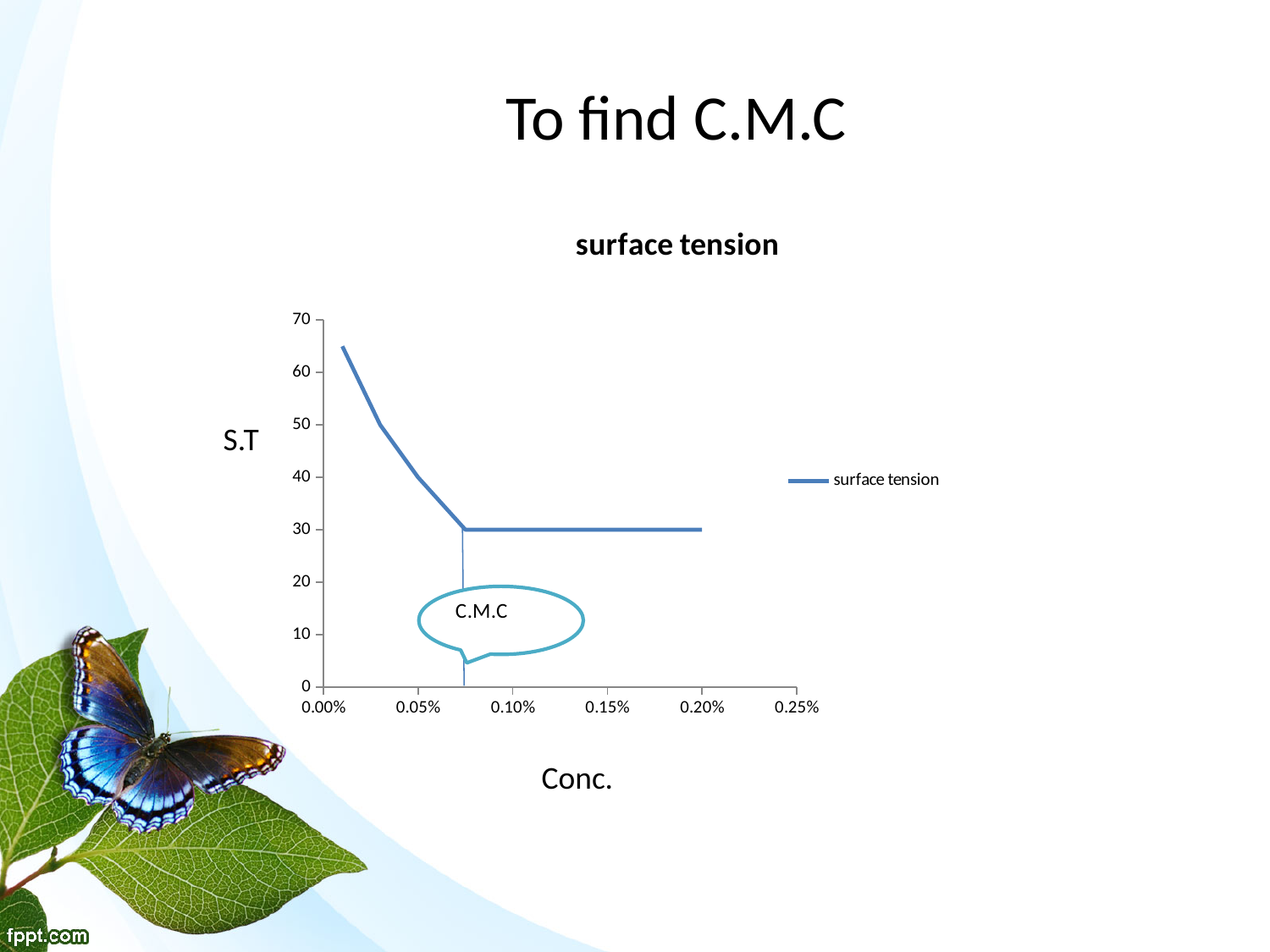
What kind of chart is shown on the slide? line chart Does the surface tension rise, fall or stay flat between 0.10% and 0.20% concentration? stay flat Is the surface tension value at 0.10% concentration greater or less than 40? less Is the surface tension at 0.05% concentration larger or smaller than at 0.15% concentration? larger Is the surface tension value at 0.05% concentration greater or less than 30? greater What is the title of the chart? surface tension How many series does the legend list? 1 What is the surface tension value at 0.20% concentration? 30 Is the surface tension value at 0.05% concentration greater or less than 50? less What is the name of the series shown in the legend? surface tension Does the surface tension rise or fall as concentration increases from 0.00% to 0.05%? fall